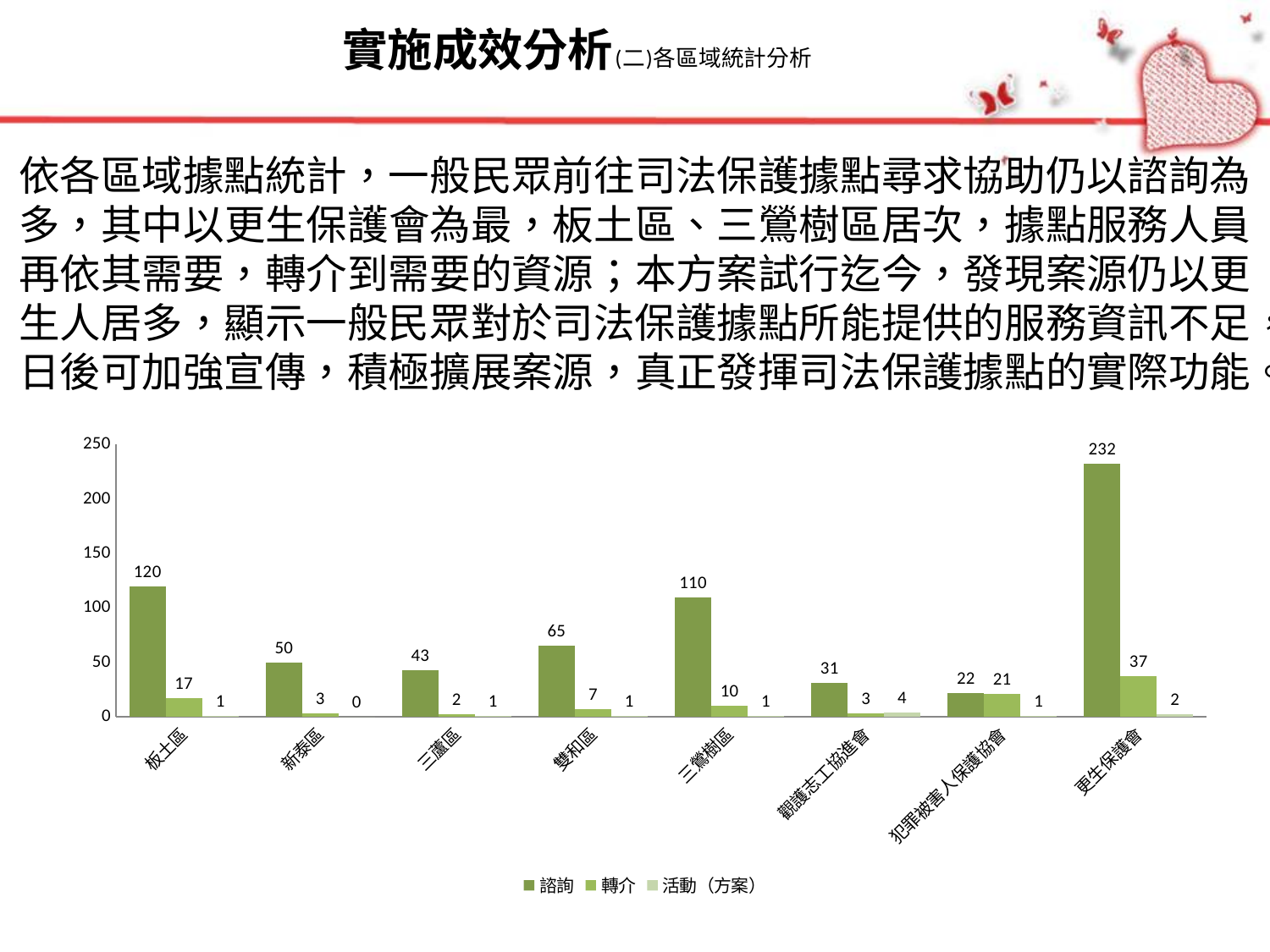
What type of chart is shown on the slide? bar chart What is the 活動（方案） value for 觀護志工協進會? 4 Which is larger, the 諮詢 value for 雙和區 or for 新泰區? 雙和區 Which category has the highest 諮詢 value? 更生保護會 What is the total of the three series for 犯罪被害人保護協會? 44 Which category has the lowest 諮詢 value? 犯罪被害人保護協會 What is the 轉介 value for 板土區? 17 How many categories are shown on the x axis? 8 How many series does the legend list? 3 What is the difference between the 諮詢 values for 板土區 and 三鶯樹區? 10 What is the 諮詢 value for 更生保護會? 232 Is the 諮詢 value for 更生保護會 greater or less than 200? greater